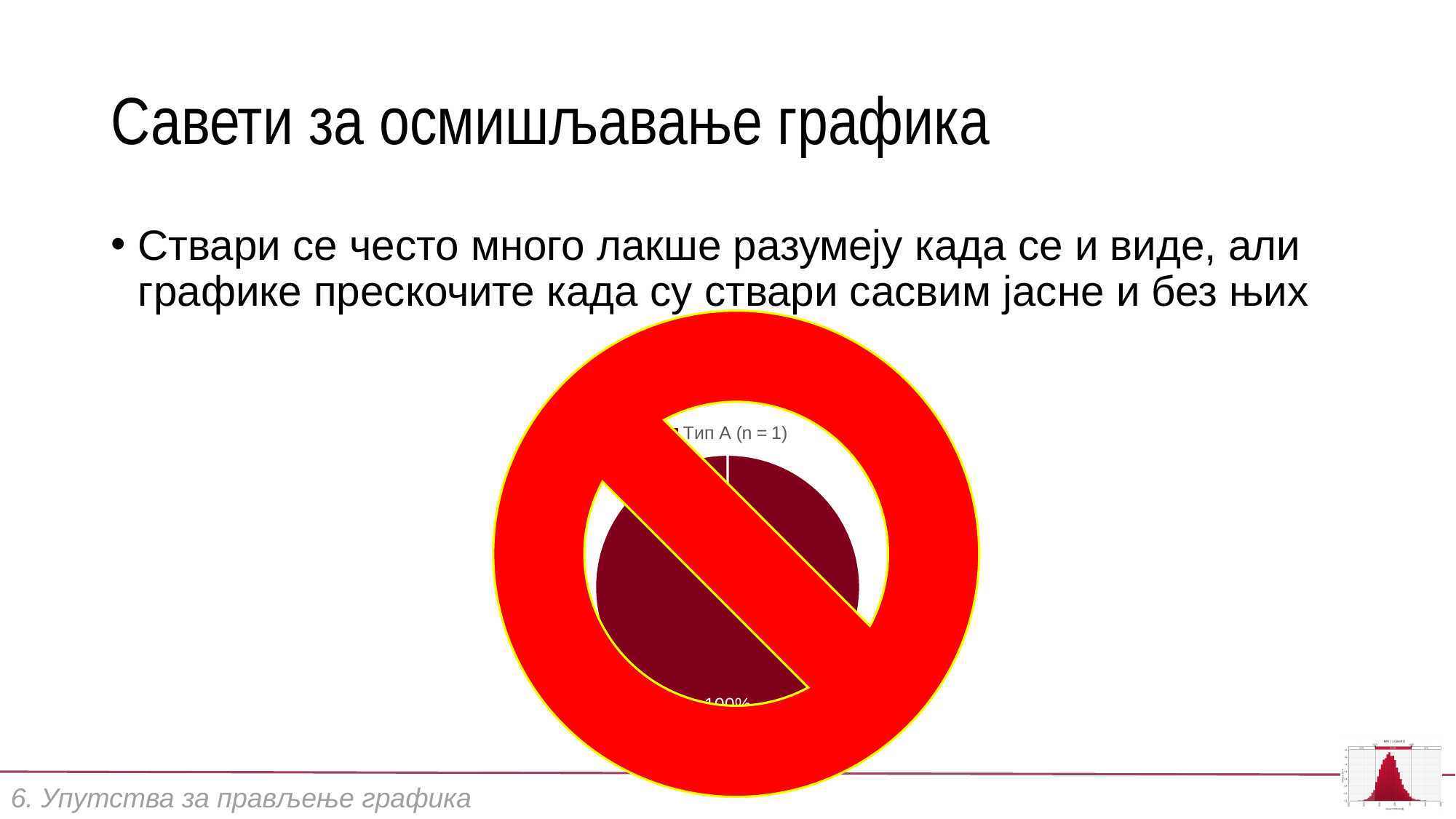
What is the data label shown on the pie slice? 100% What is the legend entry of the pie chart? Тип А (n = 1) How many entries does the legend of the pie chart list? 1 What share of the pie does the slice Тип А (n = 1) take? 100% How many slices does the pie chart have? 1 What kind of chart is shown on the slide? pie chart What symbol is drawn over the pie chart? a red prohibition (no) sign